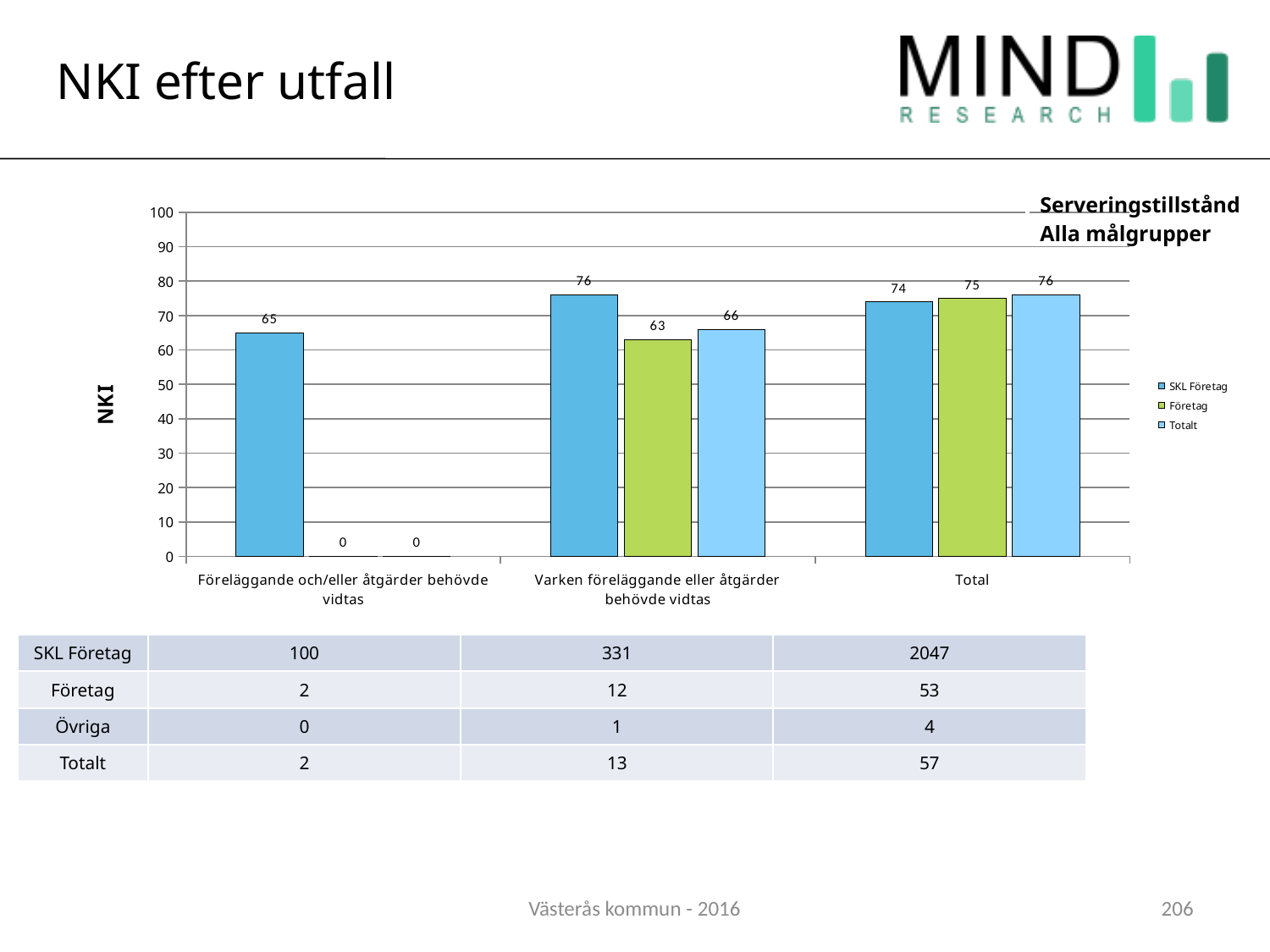
What is the NKI value for Totalt in the 'Total' category? 76 Which category has the lowest NKI value for Totalt? Föreläggande och/eller åtgärder behövde vidtas What is the difference between the SKL Företag value and the Företag value in the category 'Varken föreläggande eller åtgärder behövde vidtas'? 13 What is the NKI value for SKL Företag in the category 'Föreläggande och/eller åtgärder behövde vidtas'? 65 What is the NKI value for SKL Företag in the 'Total' category? 74 What type of chart is shown on the slide? Bar chart What is the NKI value for Företag in the category 'Varken föreläggande eller åtgärder behövde vidtas'? 63 How many categories are shown on the x axis of the chart? 3 Is the SKL Företag value for 'Föreläggande och/eller åtgärder behövde vidtas' greater or less than 70? less In the 'Total' category, which is larger: the value for SKL Företag or the value for Totalt? Totalt Which category has the highest NKI value for SKL Företag? Varken föreläggande eller åtgärder behövde vidtas How many series does the chart legend list? 3